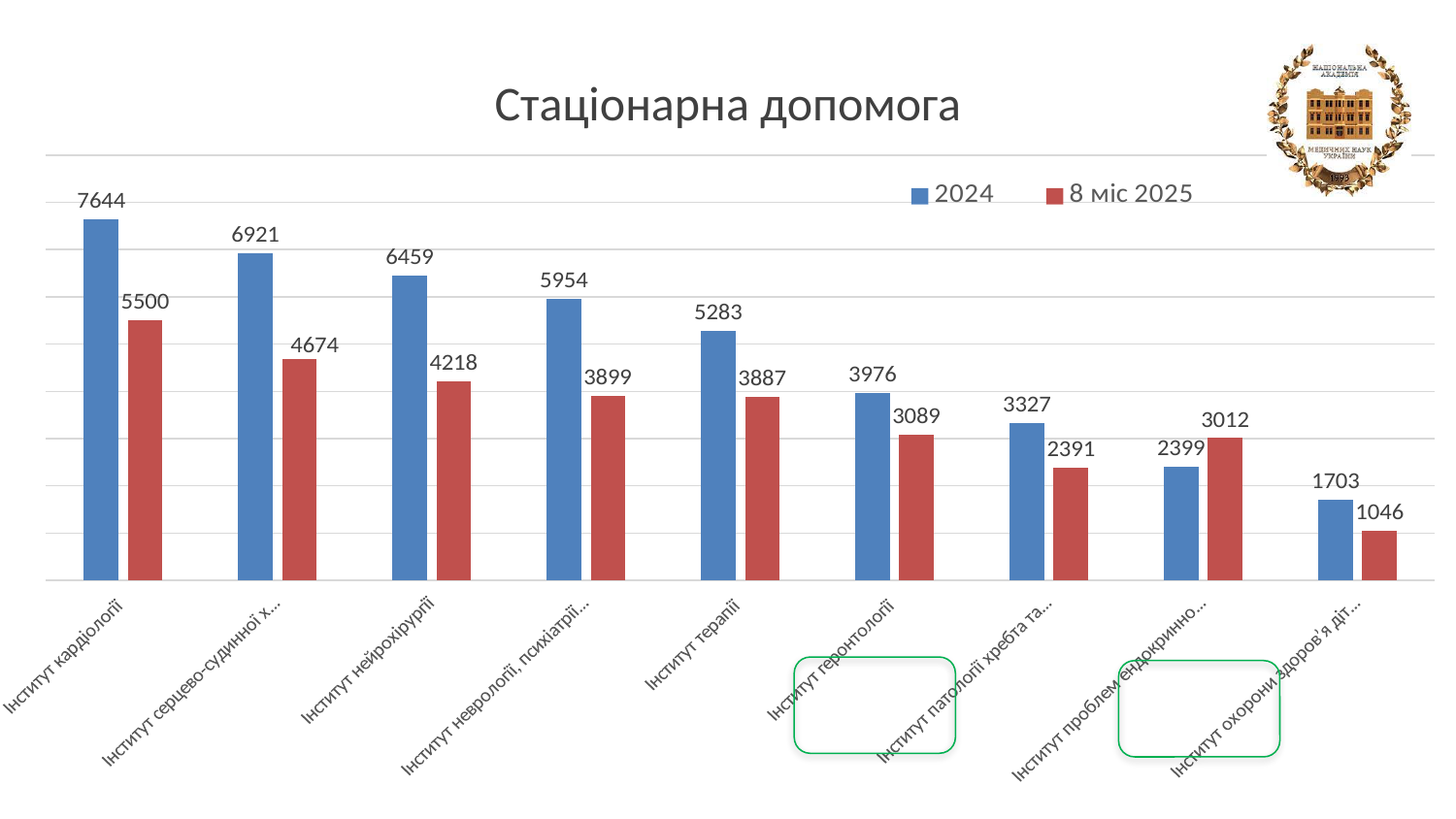
What is the 8 міс 2025 value for Інститут геронтології? 3089 Which institute has the lowest 8 міс 2025 value? Інститут охорони здоров'я діт... What is the 2024 value for Інститут терапії? 5283 How many series does the legend list? 2 What is the 2024 value for Інститут кардіології? 7644 What is the title of the chart? Стаціонарна допомога Which institute has the highest 2024 value? Інститут кардіології What is the difference between the 2024 and 8 міс 2025 values for Інститут кардіології? 2144 What kind of chart is shown on the slide? Bar chart What is the 8 міс 2025 value for Інститут нейрохірургії? 4218 For Інститут проблем ендокринно..., which is larger: the 2024 value or the 8 міс 2025 value? 8 міс 2025 How many institutes are shown on the x axis? 9